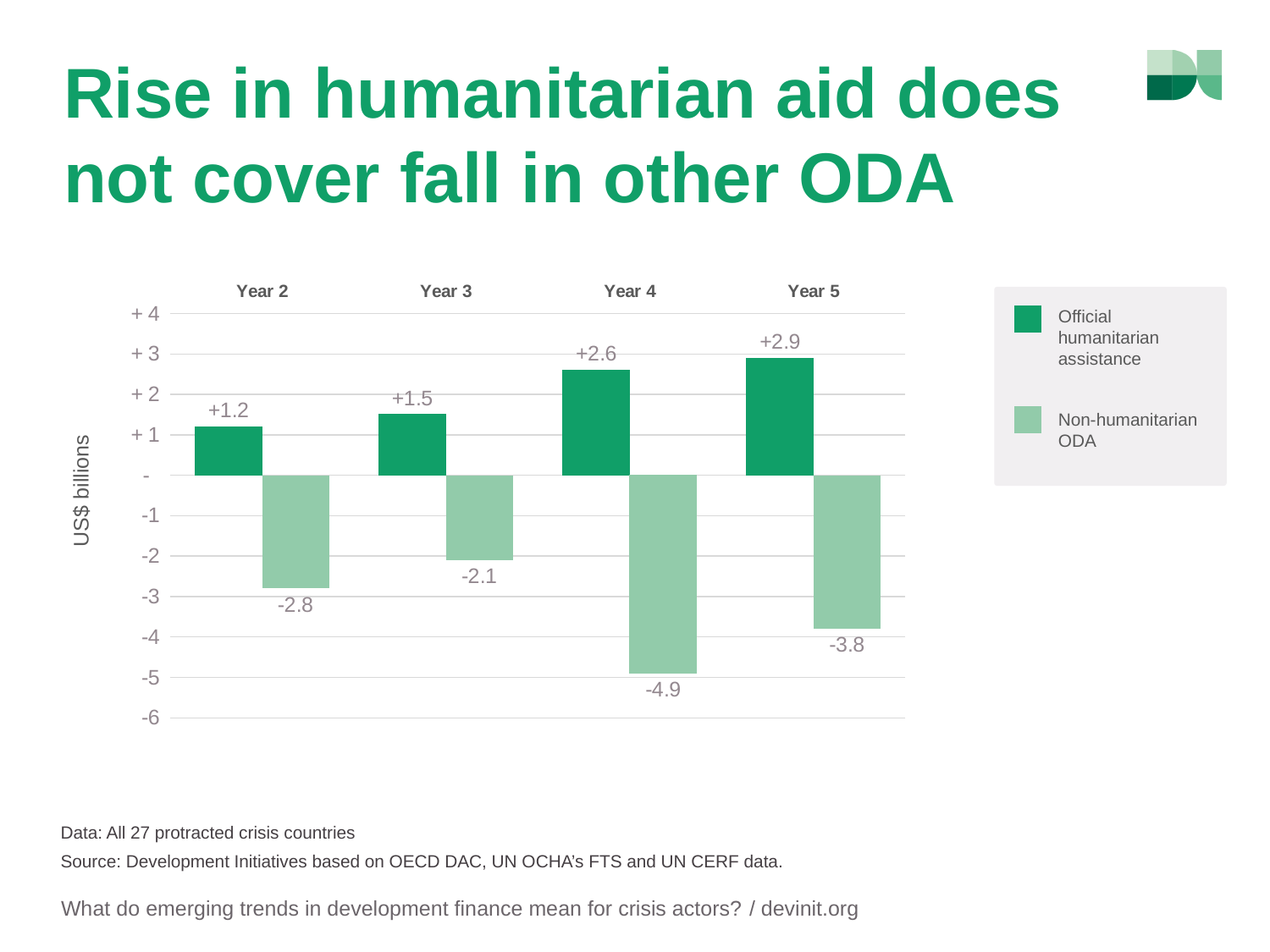
What is the value for Non-humanitarian ODA in Year 5? -3.8 What unit is shown on the y axis? US$ billions In which year is Official humanitarian assistance highest? Year 5 What is the difference between Official humanitarian assistance in Year 5 and Year 2? 1.7 Does Official humanitarian assistance rise or fall from Year 2 to Year 5? Rise Which is larger in absolute size in Year 4: the rise in Official humanitarian assistance or the fall in Non-humanitarian ODA? Non-humanitarian ODA What kind of chart is shown on the slide? Bar chart How many series does the legend list? 2 What is the value for Official humanitarian assistance in Year 4? +2.6 How many years are shown on the x axis? 4 In which year is Non-humanitarian ODA lowest? Year 4 What is the value for Non-humanitarian ODA in Year 3? -2.1